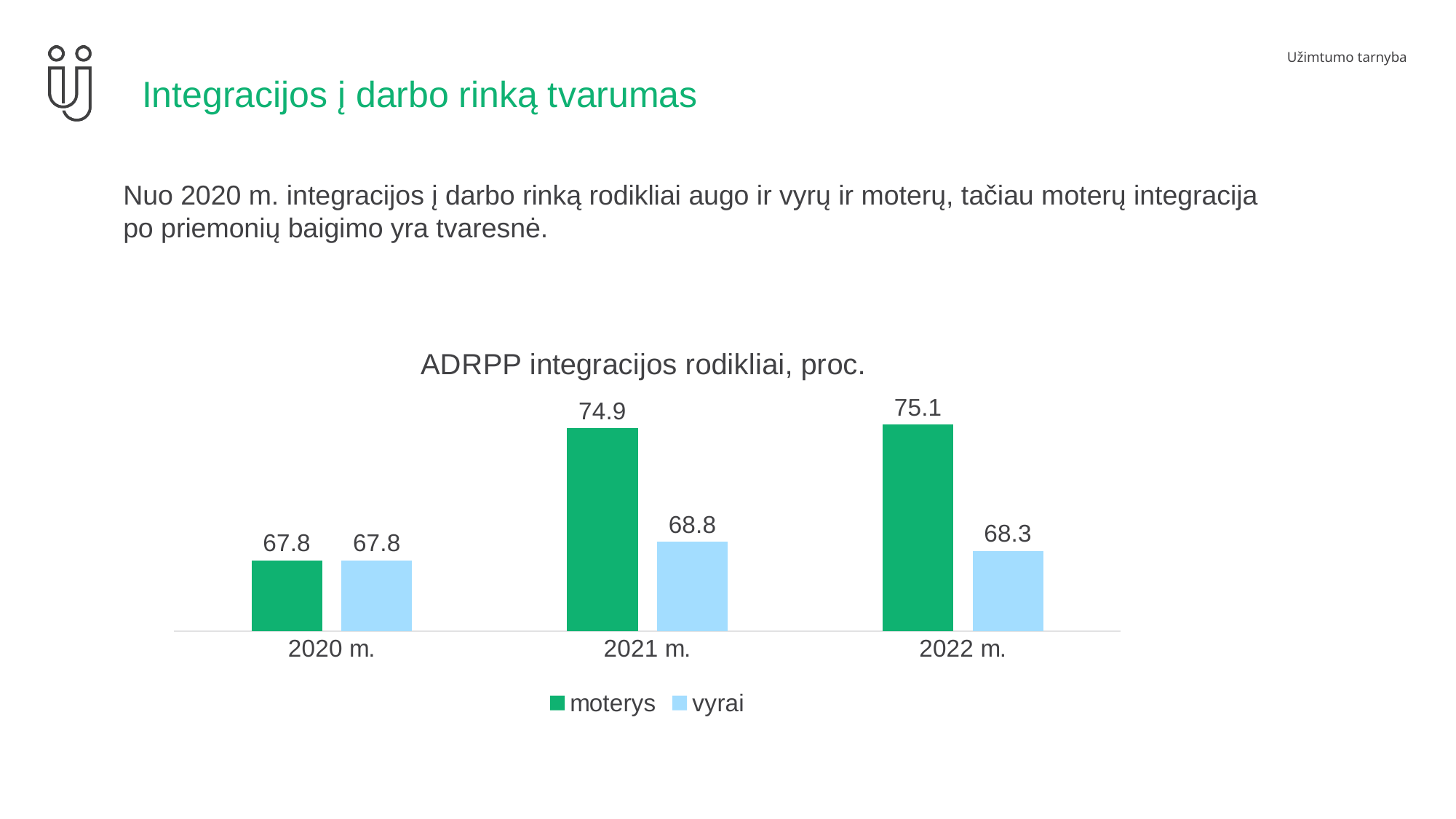
What kind of chart is shown? bar chart What is the difference between the moterys values in 2021 m. and 2020 m.? 7.1 What is the value for vyrai in 2020 m.? 67.8 What is the difference between the moterys and vyrai values in 2022 m.? 6.8 How many series does the legend list? 2 In which year is the vyrai value lowest? 2020 m. Which is larger in 2021 m., the moterys value or the vyrai value? moterys In which year is the moterys value highest? 2022 m. How many years are shown on the x axis? 3 What is the value for moterys in 2021 m.? 74.9 What is the value for vyrai in 2022 m.? 68.3 What is the title of the chart? ADRPP integracijos rodikliai, proc.